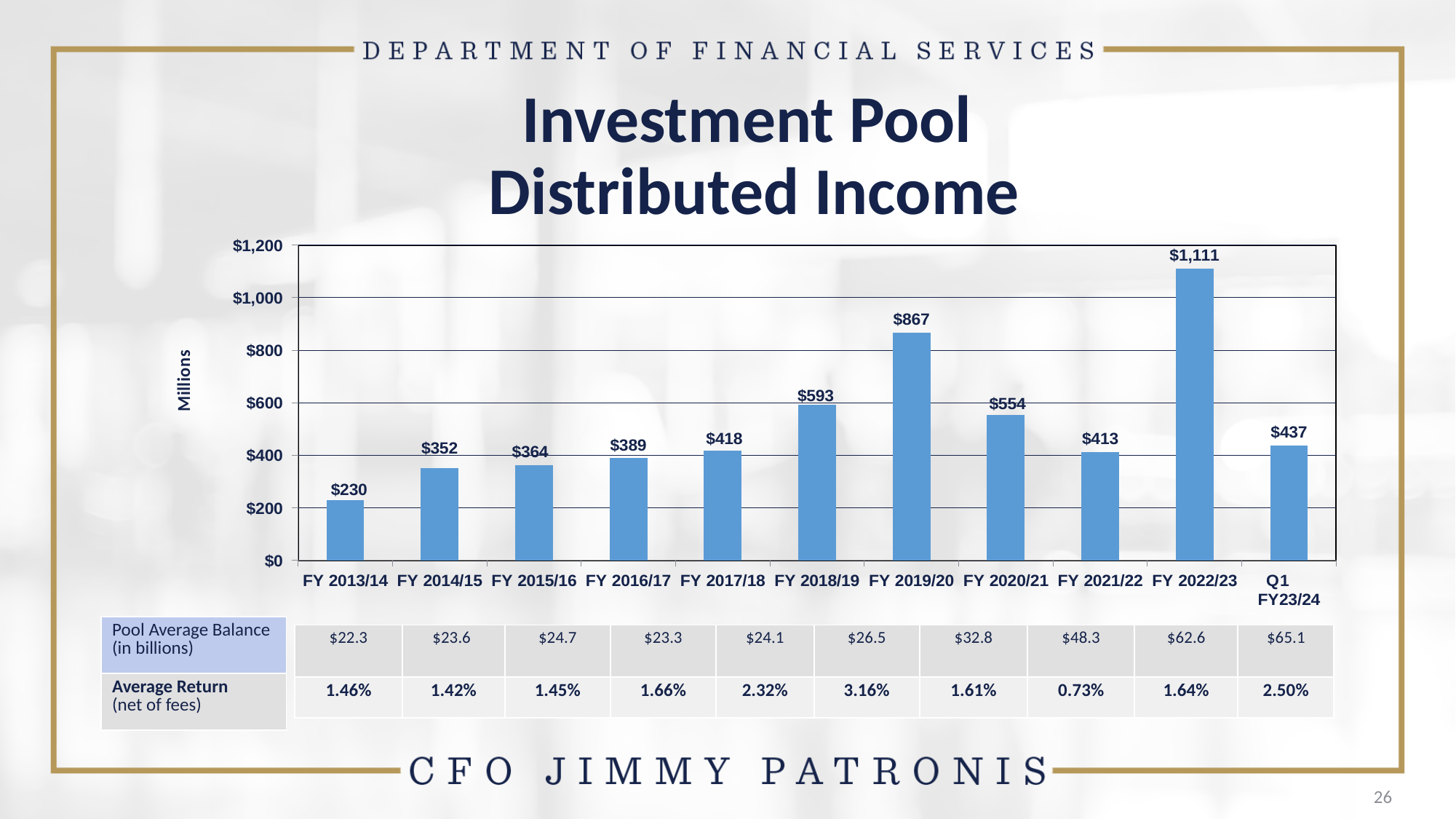
Is the value for FY 2018/19 greater or less than $400? greater What is the difference between the distributed income for FY 2022/23 and FY 2019/20? $244 How many bars are shown in the chart? 11 What is the distributed income for FY 2013/14? $230 What is the distributed income for Q1 FY23/24? $437 What kind of chart is shown on the slide? Bar chart What is the distributed income for FY 2019/20? $867 Do the distributed income values rise or fall from FY 2013/14 to FY 2017/18? Rise What is the label on the vertical axis of the chart? Millions Which is larger, the distributed income for FY 2020/21 or FY 2021/22? FY 2020/21 Which fiscal year has the lowest distributed income? FY 2013/14 Which fiscal year has the highest distributed income? FY 2022/23